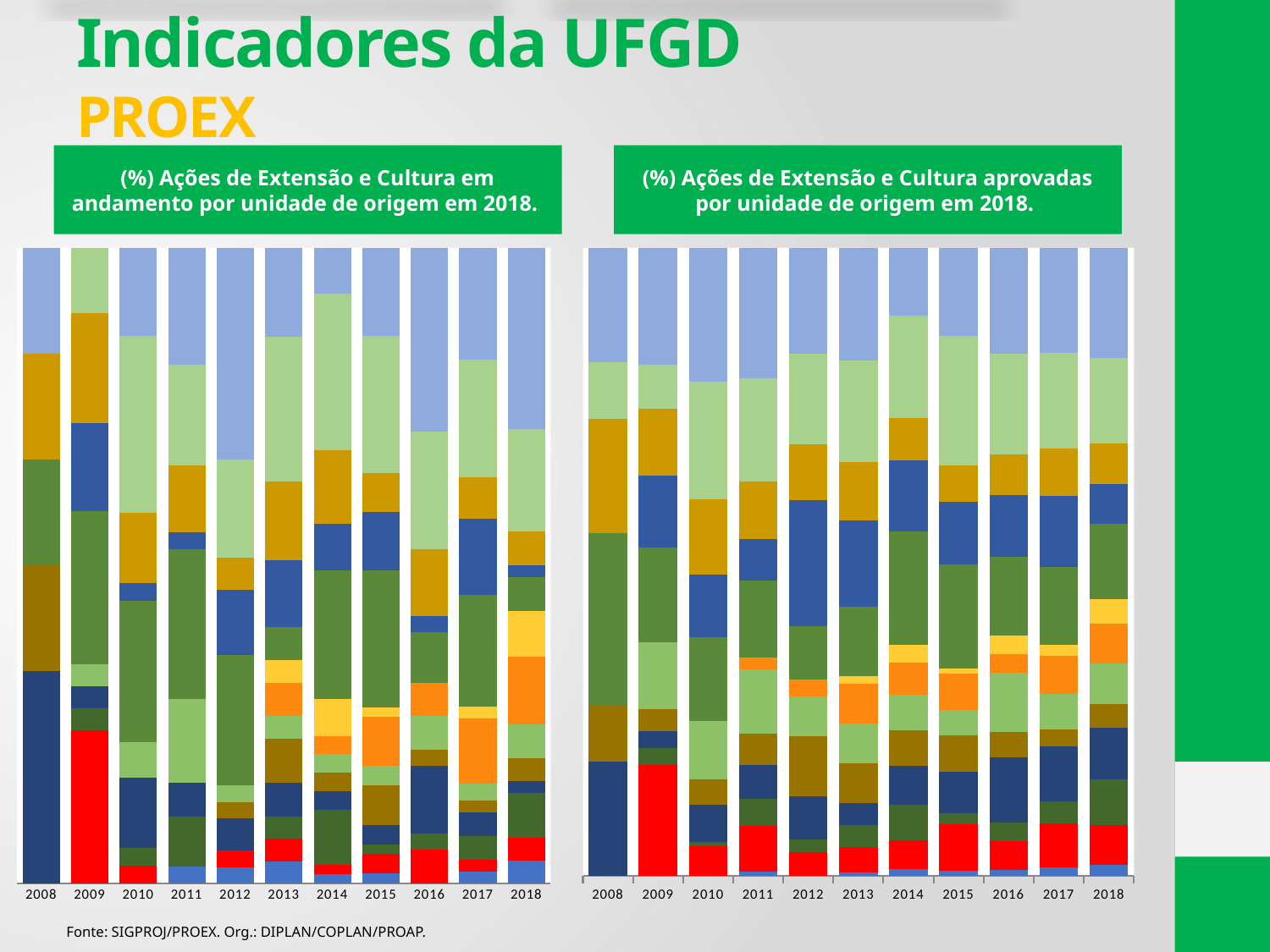
In the right chart, what is the last year shown on the x axis? 2018 What kind of chart is the left chart, '(%) Ações de Extensão e Cultura em andamento por unidade de origem em 2018'? Stacked bar chart What kind of chart is the right chart, '(%) Ações de Extensão e Cultura aprovadas por unidade de origem em 2018'? Stacked bar chart What source is cited for the charts on the slide? SIGPROJ/PROEX. Org.: DIPLAN/COPLAN/PROAP. How many years are shown on the x axis of the right chart? 11 In the left chart, in which year is the red segment the largest? 2009 What is the title of the chart on the right? (%) Ações de Extensão e Cultura aprovadas por unidade de origem em 2018. How many years are shown on the x axis of the left chart? 11 In the right chart, in which year is the red segment the largest? 2009 In the left chart, what is the first year shown on the x axis? 2008